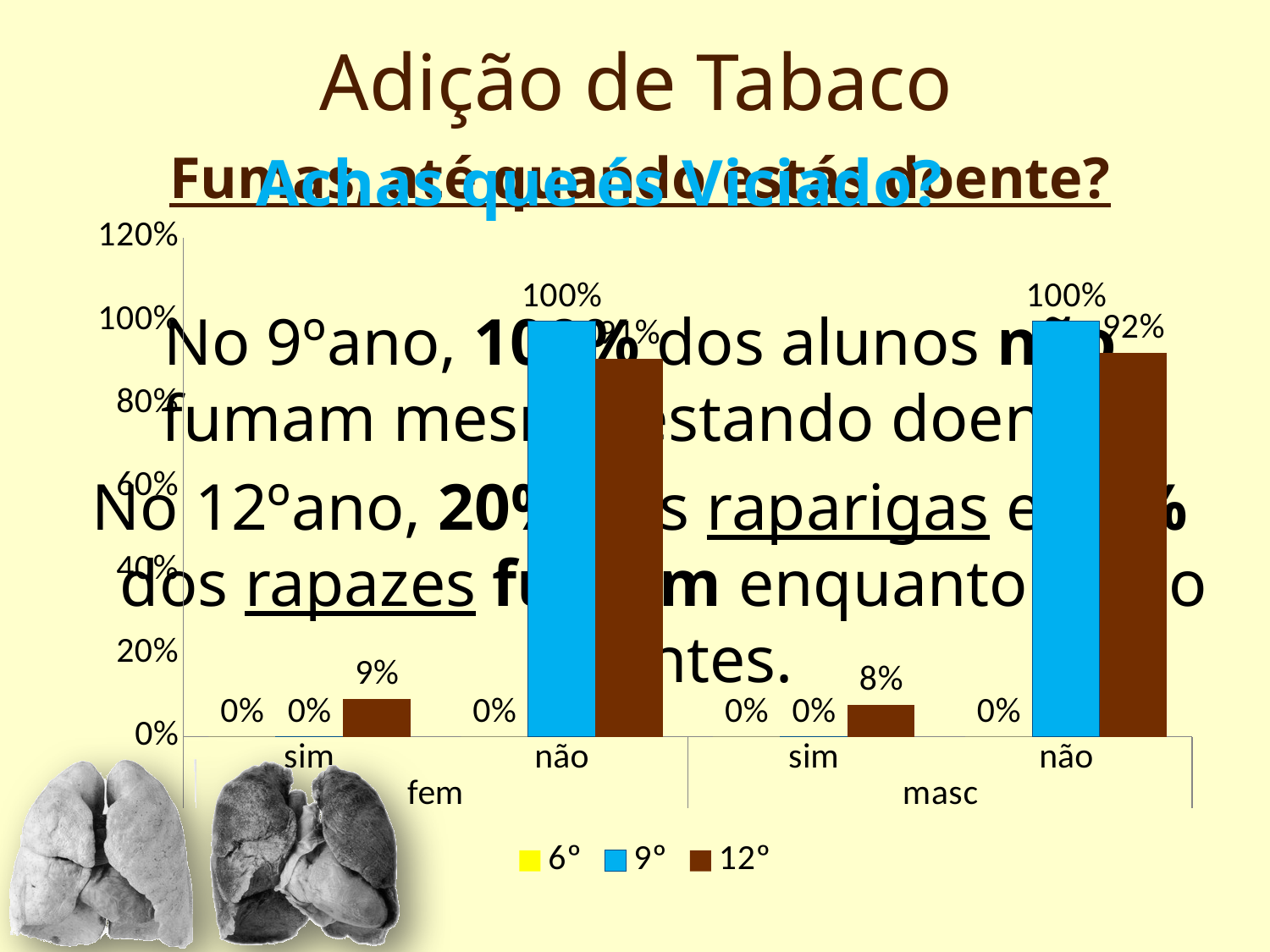
What kind of chart is shown on the slide? bar chart What is the value for 12° in the masc sim category? 8% In the masc não category, what is the difference between the 9° value and the 12° value? 8% What is the value for 12° in the masc não category? 92% What is the value for 12° in the fem sim category? 9% How many series does the legend list? 3 What is the value for 6° in the fem sim category? 0% In the masc não category, which series has the highest value? 9° What is the value for 9° in the fem não category? 100% What is the value for 9° in the masc não category? 100% What colour represents the 9° series in the legend? blue For the 12° series, which is larger: fem sim or masc sim? fem sim